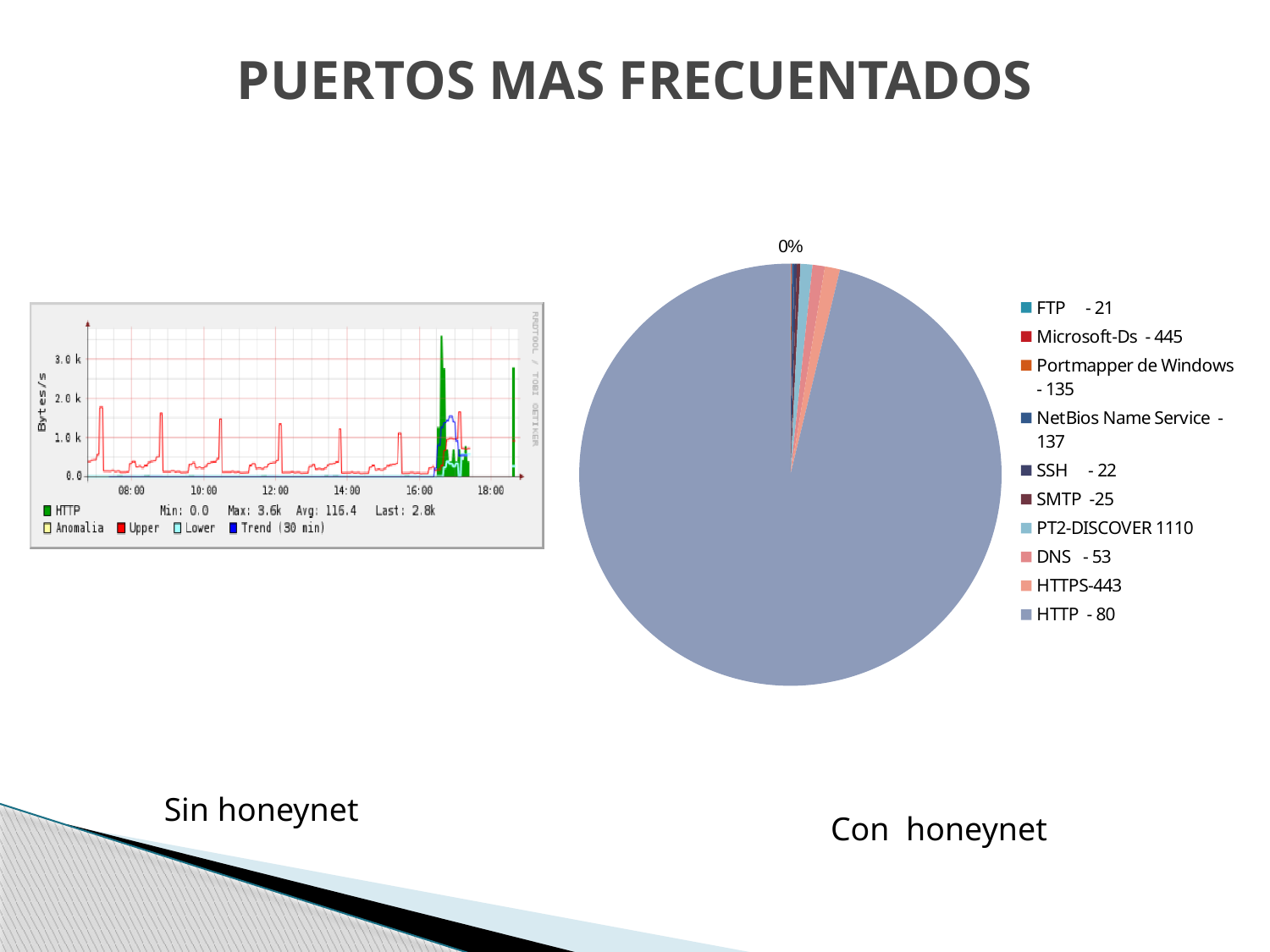
In the 'Sin honeynet' line chart, what is the Max value shown for HTTP? 3.6k In the 'Con honeynet' pie chart, what is the only percentage data label printed on the chart? 0% What kind of chart is the 'Con honeynet' chart on the right of the slide? pie chart In the 'Con honeynet' pie chart, which category has the largest slice? HTTP - 80 What kind of chart is the 'Sin honeynet' chart on the left of the slide? line chart In the 'Sin honeynet' line chart, how many entries does the legend list? 5 In the 'Con honeynet' pie chart, how many categories does the legend list? 10 In the 'Sin honeynet' line chart, what is the Avg value shown for HTTP? 116.4 In the 'Sin honeynet' line chart, what is the Last value shown for HTTP? 2.8k In the 'Sin honeynet' line chart, what is the Min value shown for HTTP? 0.0 In the 'Con honeynet' pie chart, which slice is larger, HTTP - 80 or DNS - 53? HTTP - 80 In the 'Sin honeynet' line chart, what is the label on the y axis? Bytes/s